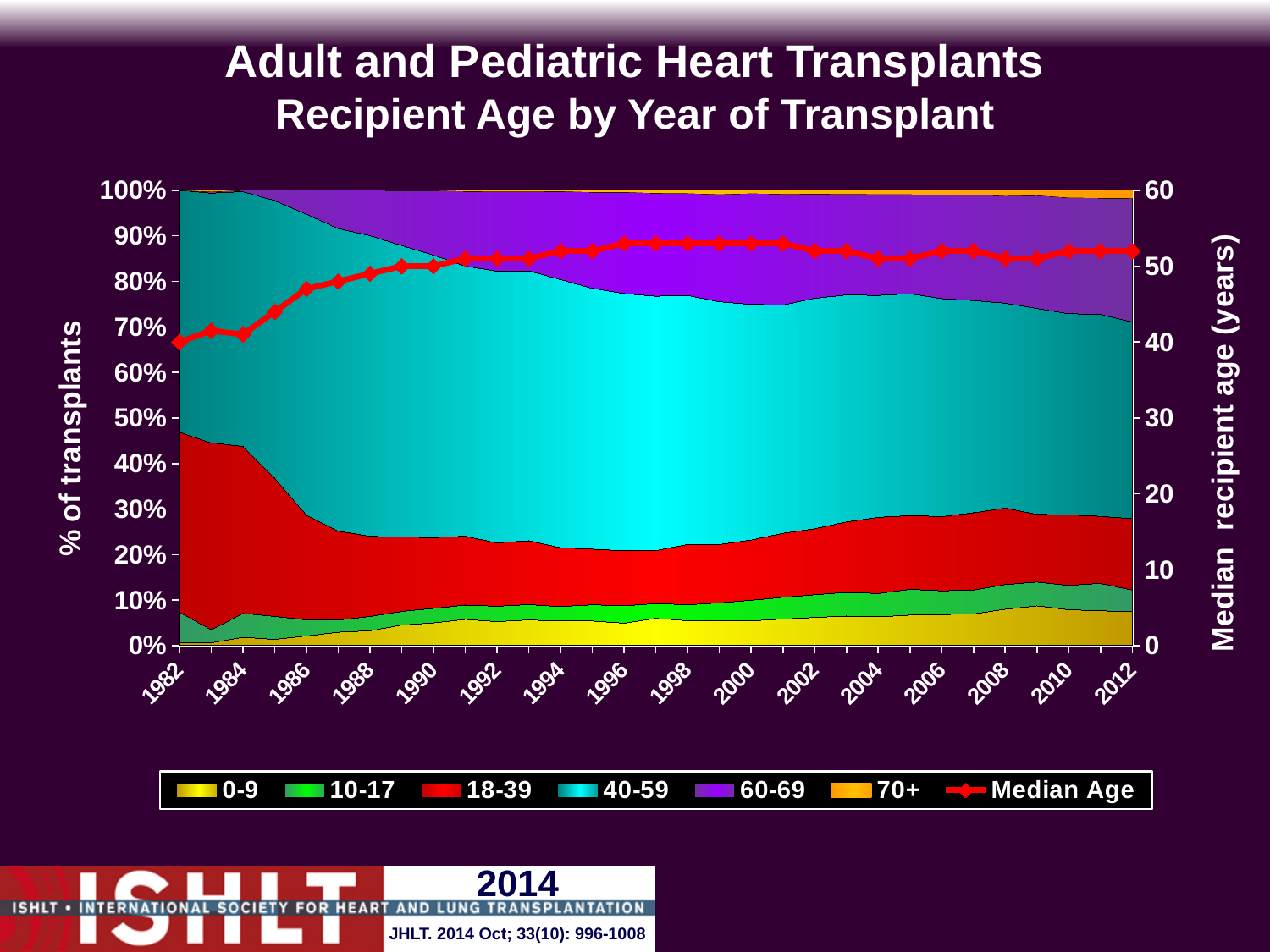
What kind of chart is shown on the slide? stacked area chart with a line What is the title of the right-hand vertical axis? Median recipient age (years) Is the median recipient age in 1982 greater or less than 50 years? less How many year labels are shown along the x axis? 16 Is the median recipient age in 1982 greater or less than 30 years? greater Is the median recipient age in 2012 greater or less than 50 years? greater How many series does the legend list? 7 Which age group accounts for the smallest share of transplants in 2012? 70+ Does the median recipient age rise or fall between 1982 and 1990? rise In 2012, which age group has the larger share of transplants, 18-39 or 40-59? 40-59 Which age group accounts for the largest share of transplants in 2012? 40-59 Which is larger, the median recipient age in 1982 or in 2012? 2012